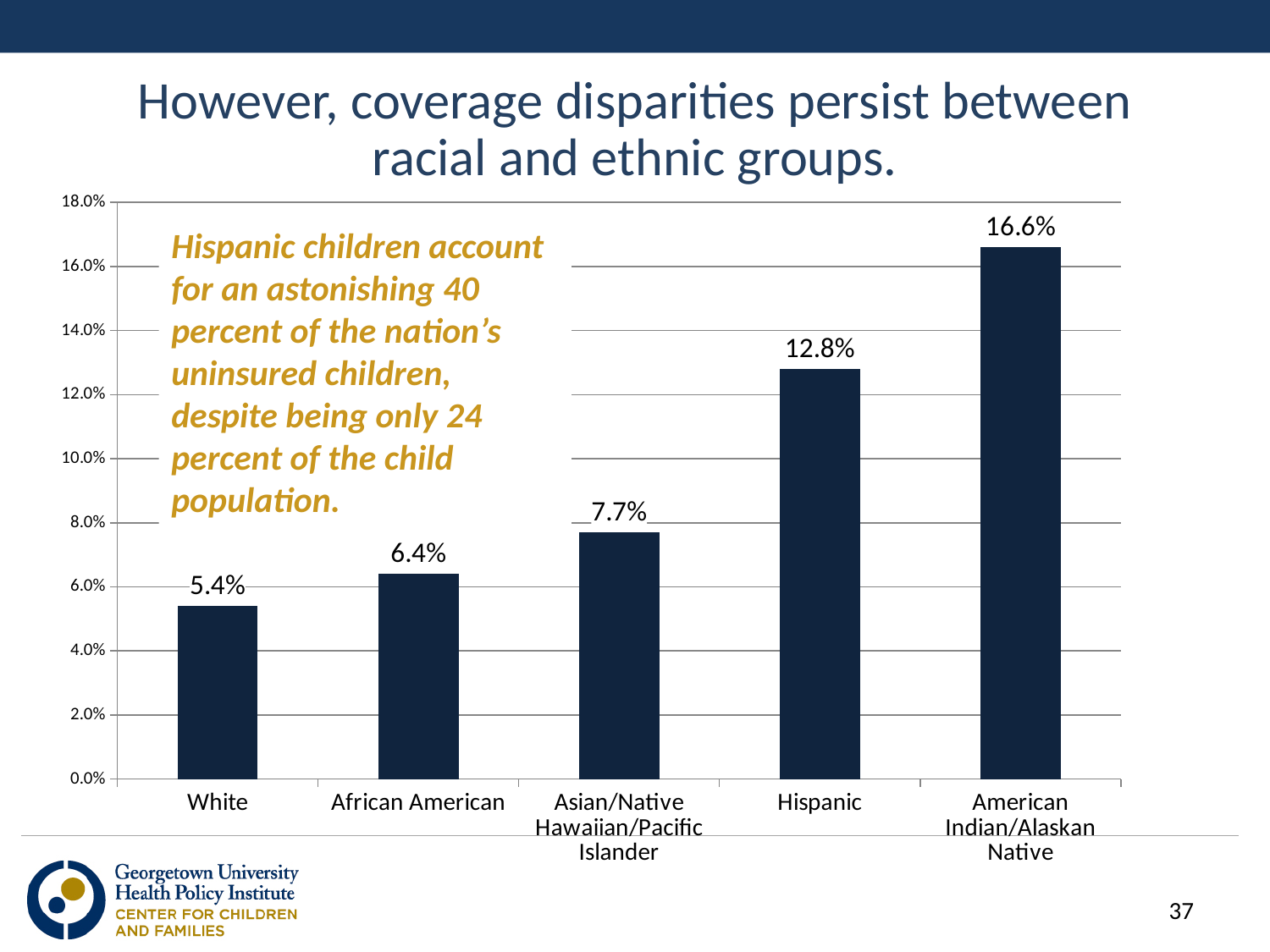
Do the values rise or fall from left to right along the x axis? rise What is the difference between the values for African American and White? 1.0% What is the value for White? 5.4% Which category has the highest value? American Indian/Alaskan Native What is the difference between the values for American Indian/Alaskan Native and Hispanic? 3.8% What kind of chart is shown on the slide? bar chart Is the value for Hispanic greater or less than 10.0%? greater How many categories are shown on the x axis? 5 Which category has the lowest value? White Which is larger, the value for African American or the value for Asian/Native Hawaiian/Pacific Islander? Asian/Native Hawaiian/Pacific Islander What is the value for Hispanic? 12.8% What is the value for Asian/Native Hawaiian/Pacific Islander? 7.7%